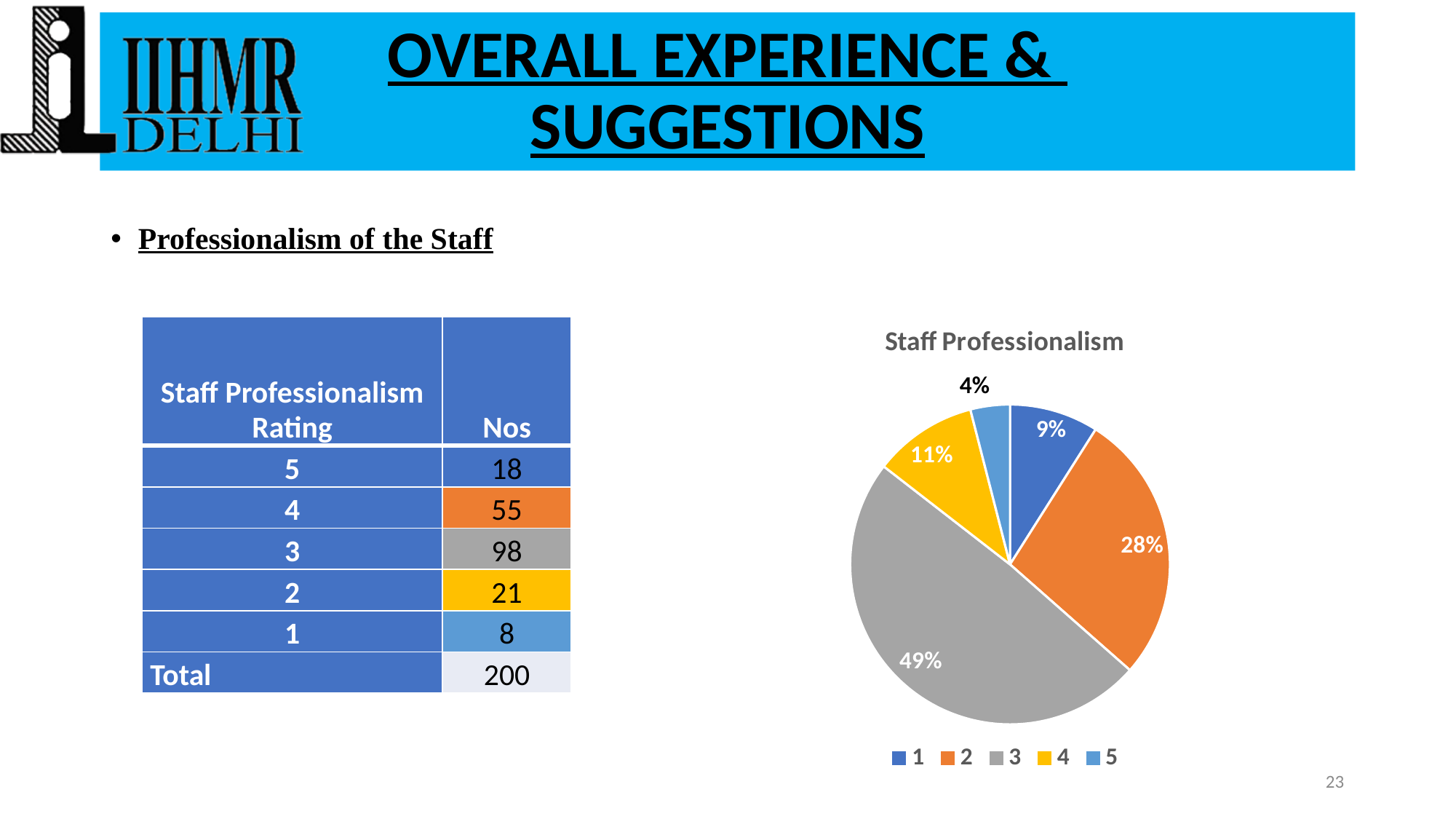
In the Staff Professionalism pie chart, what share does the orange slice have? 28% What is the share of the largest slice in the Staff Professionalism pie chart? 49% In the Staff Professionalism pie chart, what share does the yellow slice have? 11% In the Staff Professionalism pie chart, what is the difference in percentage points between the orange slice and the dark blue slice? 19 percentage points In the Staff Professionalism pie chart, what share does the slice for category 3 have? 49% What is the title of the pie chart? Staff Professionalism How many entries does the legend of the Staff Professionalism pie chart list? 5 In the Staff Professionalism pie chart, what is the difference in percentage points between the largest slice and the smallest slice? 45 percentage points How many slices does the Staff Professionalism pie chart have? 5 What kind of chart is shown on the slide? pie chart What is the share of the smallest slice in the Staff Professionalism pie chart? 4% In the Staff Professionalism pie chart, which slice is larger, the orange one or the yellow one? the orange one